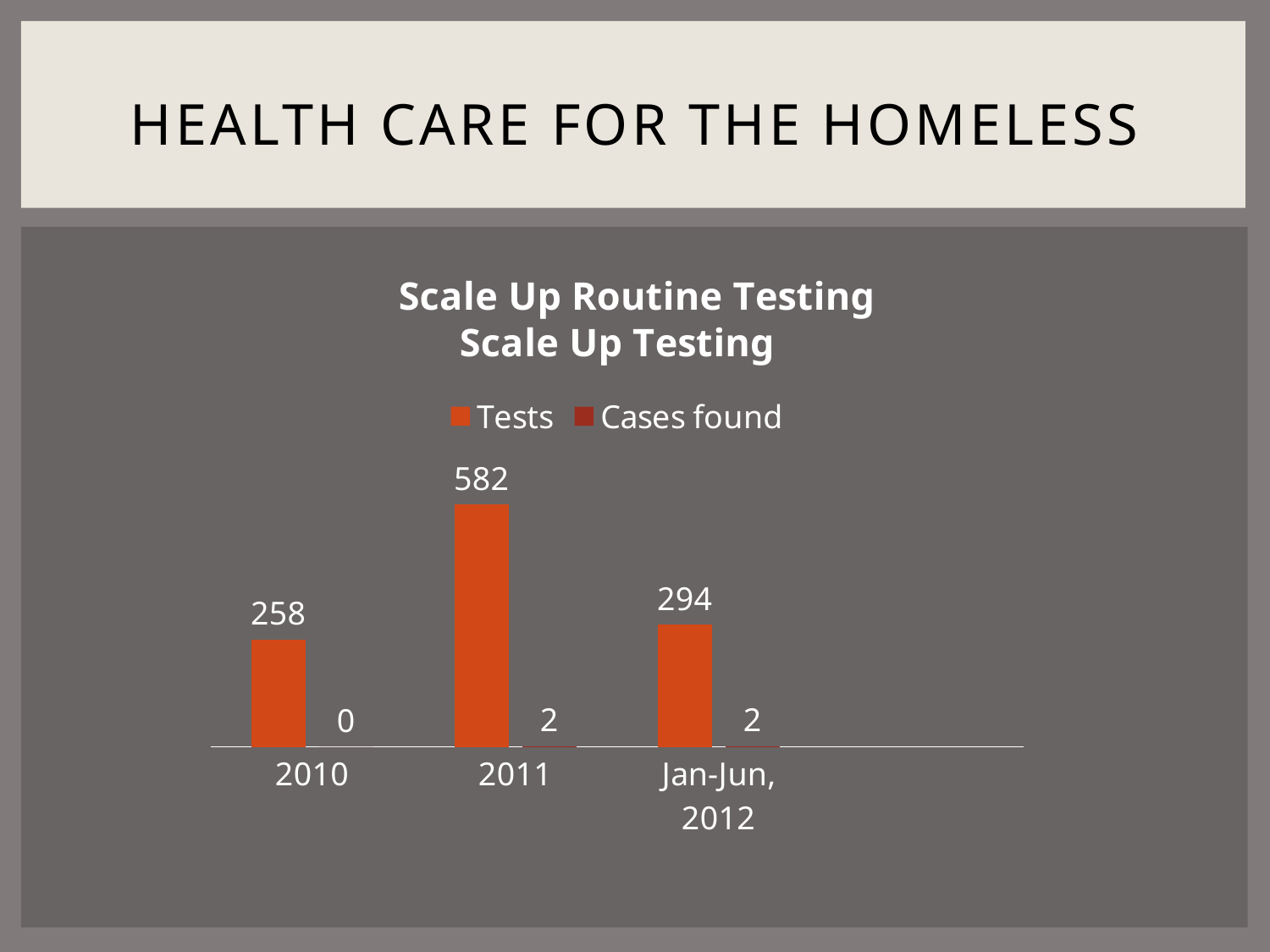
What is the difference in tests between 2011 and 2010? 324 How many periods are shown on the x axis? 3 How many cases were found in Jan-Jun, 2012? 2 How many series does the legend list? 2 Which period had the lowest number of tests? 2010 What are the two series named in the legend? Tests and Cases found How many cases were found in 2010? 0 What kind of chart is shown? Bar chart Which period had the highest number of tests? 2011 How many tests were done in 2011? 582 How many tests were done in 2010? 258 Which period had more tests, 2010 or Jan-Jun, 2012? Jan-Jun, 2012